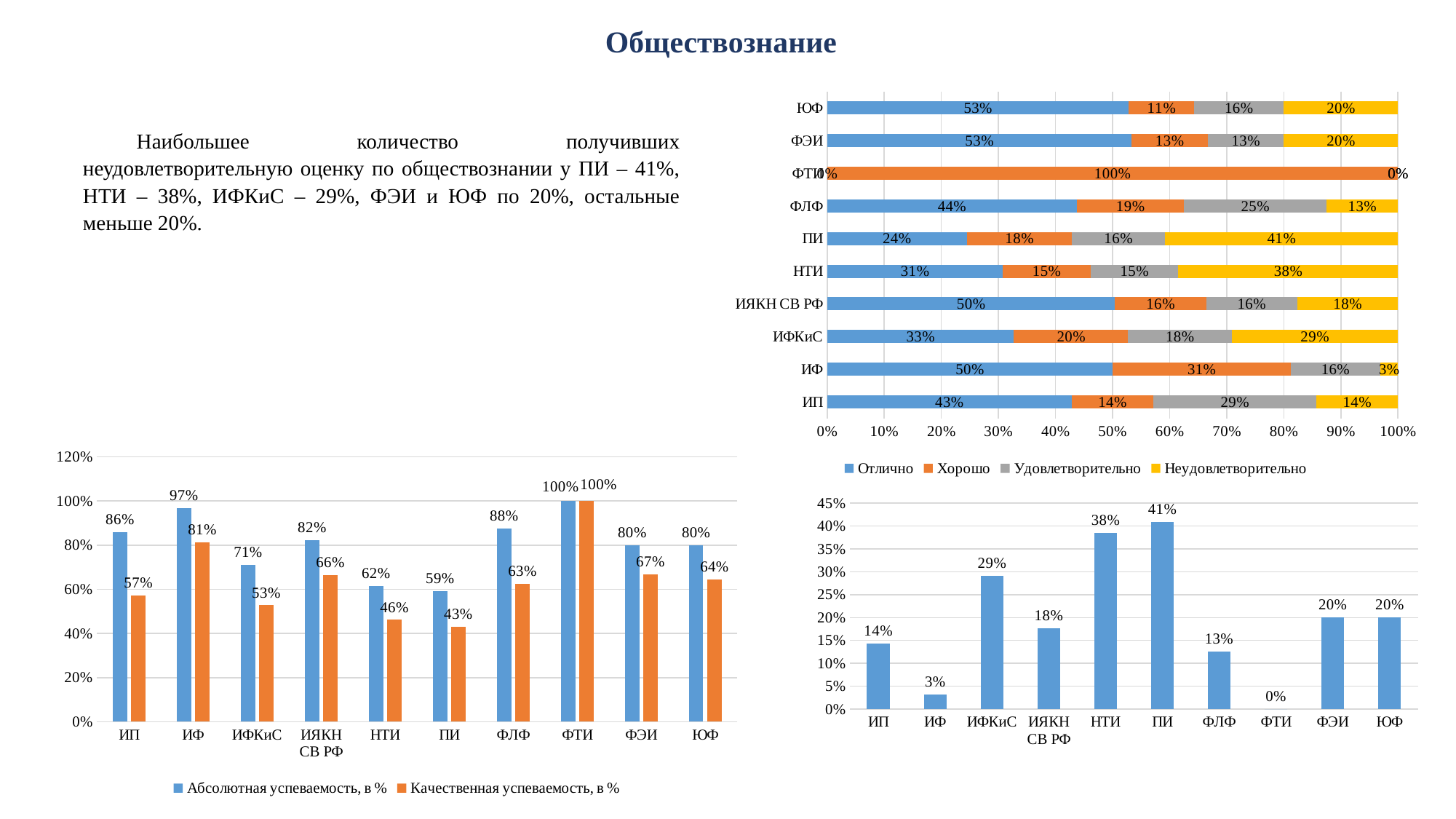
How many series does the legend of the top-right stacked bar chart list? 4 In the bottom-right chart, which category has the lowest value? ФТИ In the bottom-right chart, which is larger: the value for ИФКиС or for ИЯКН СВ РФ? ИФКиС In the bottom-right chart, which category has the highest value? ПИ In the bottom-left chart, what is the Абсолютная успеваемость value for ИФ? 97% In the bottom-left chart, what is the Качественная успеваемость value for НТИ? 46% In the bottom-left chart, how many categories are shown on the x axis? 10 In the bottom-left chart, what is the difference between Абсолютная and Качественная успеваемость for ИП? 29 percentage points What kind of chart is the bottom-right chart? Bar chart In the bottom-left chart, which category has the lowest Качественная успеваемость? ПИ In the top-right stacked bar chart, what is the Отлично share for ПИ? 24% In the top-right stacked bar chart, what is the Хорошо share for ИФ? 31%